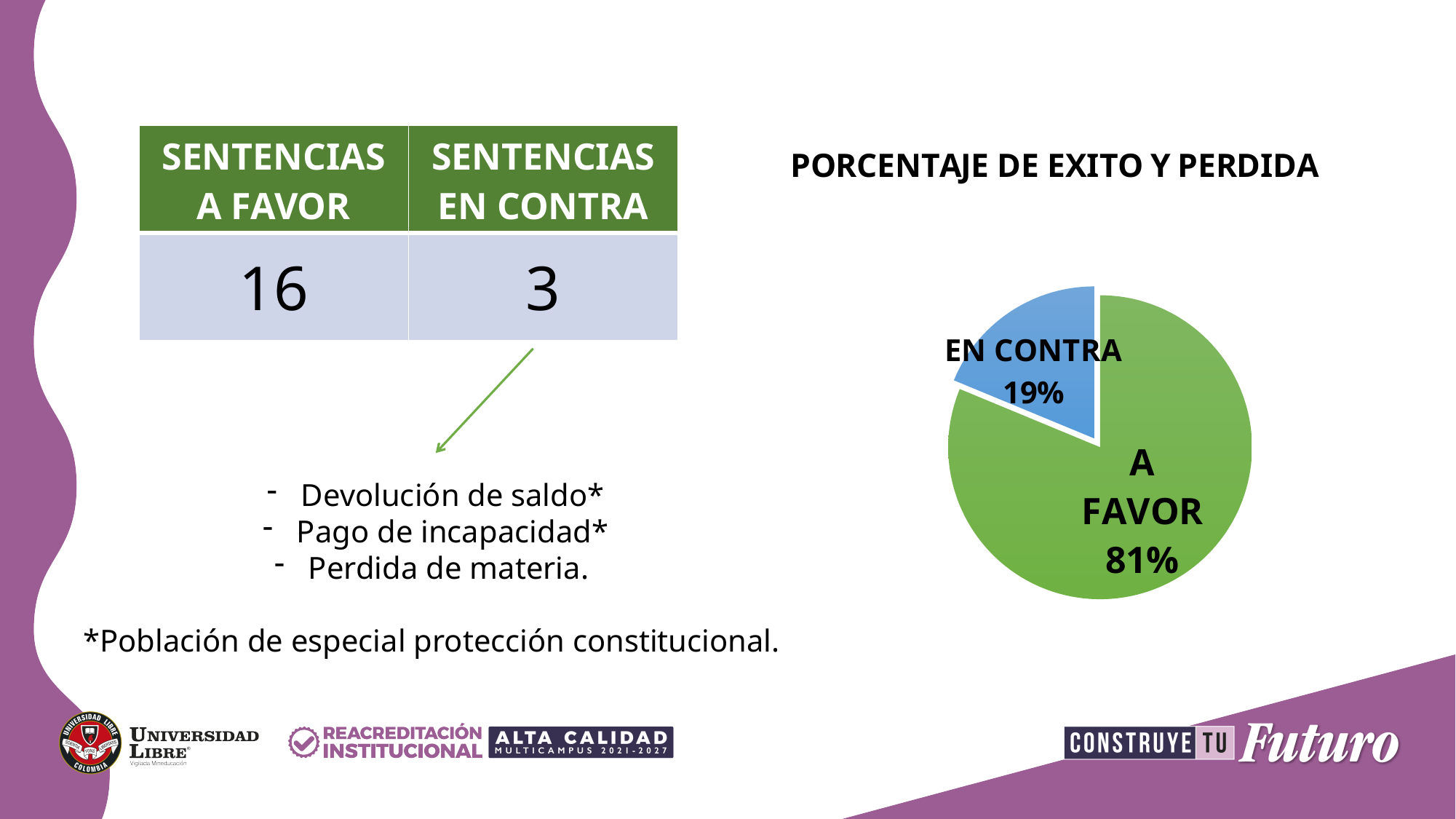
Which is larger in the pie chart, A FAVOR or EN CONTRA? A FAVOR What share of the pie does the EN CONTRA slice represent? 19% Which slice of the pie chart is the smallest? EN CONTRA What kind of chart is shown on the slide? pie chart What is the difference in percentage points between the A FAVOR and EN CONTRA slices? 62 What percentage does the A FAVOR slice show in the pie chart? 81% How many slices does the pie chart have? 2 What colour is the A FAVOR slice in the pie chart? green What percentage does the EN CONTRA slice show in the pie chart? 19% Which slice of the pie chart is the largest? A FAVOR What is the title of the pie chart? PORCENTAJE DE EXITO Y PERDIDA